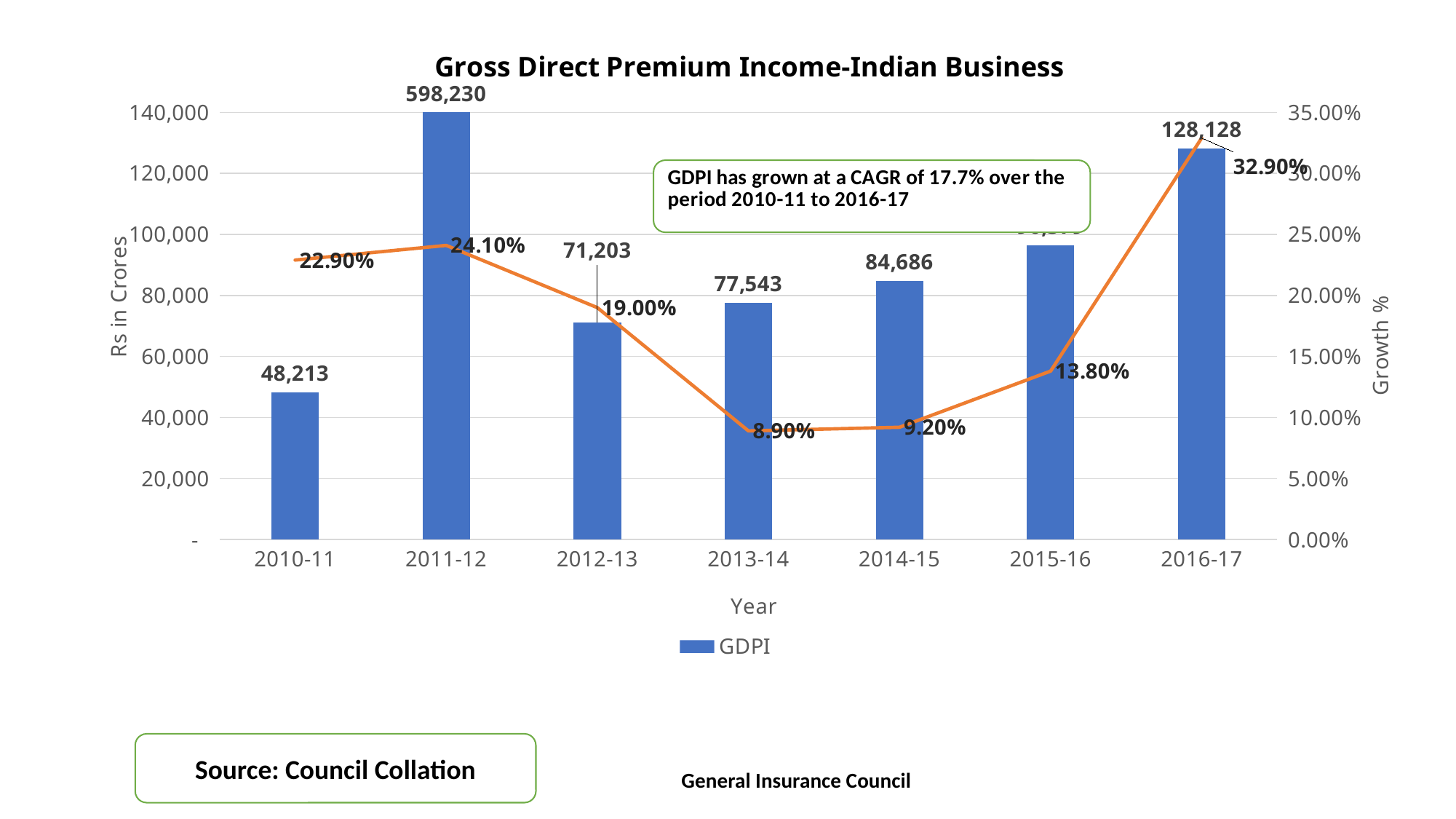
What kind of chart is this? Combination bar and line chart How many years are shown on the x axis? 7 Which year has the higher growth percentage, 2010-11 or 2011-12? 2011-12 What is the GDPI value for 2010-11? 48,213 Is the GDPI bar for 2015-16 greater or less than 80,000? greater What is the growth percentage shown for 2013-14? 8.90% What is the title of the chart? Gross Direct Premium Income-Indian Business Which year has the highest growth percentage on the line? 2016-17 What is the growth percentage shown for 2016-17? 32.90% Which year has the lowest growth percentage on the line? 2013-14 What is the difference between the GDPI values for 2014-15 and 2013-14? 7,143 What is the GDPI value for 2014-15? 84,686